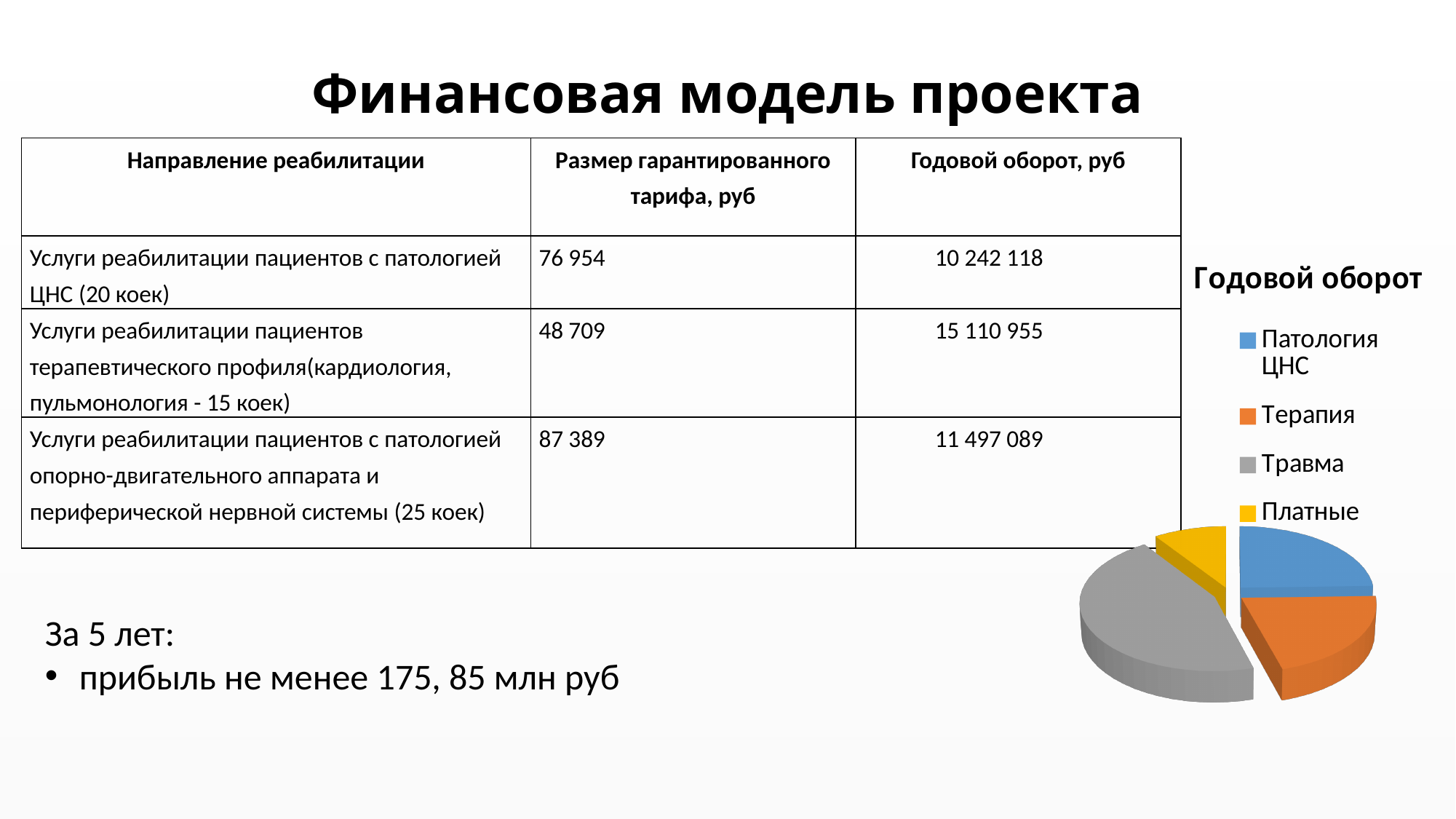
Which legend entry is shown in yellow in the pie chart? Платные Which category has the largest slice in the pie chart? Травма In the pie chart, which slice is larger: Патология ЦНС or Платные? Патология ЦНС What kind of chart is shown on the slide? pie chart In the pie chart, which slice is larger: Травма or Терапия? Травма What is the title of the pie chart? Годовой оборот What colour represents Травма in the pie chart? gray How many categories does the pie chart legend list? 4 Which category has the smallest slice in the pie chart? Платные In the pie chart, which slice is larger: Травма or Платные? Травма